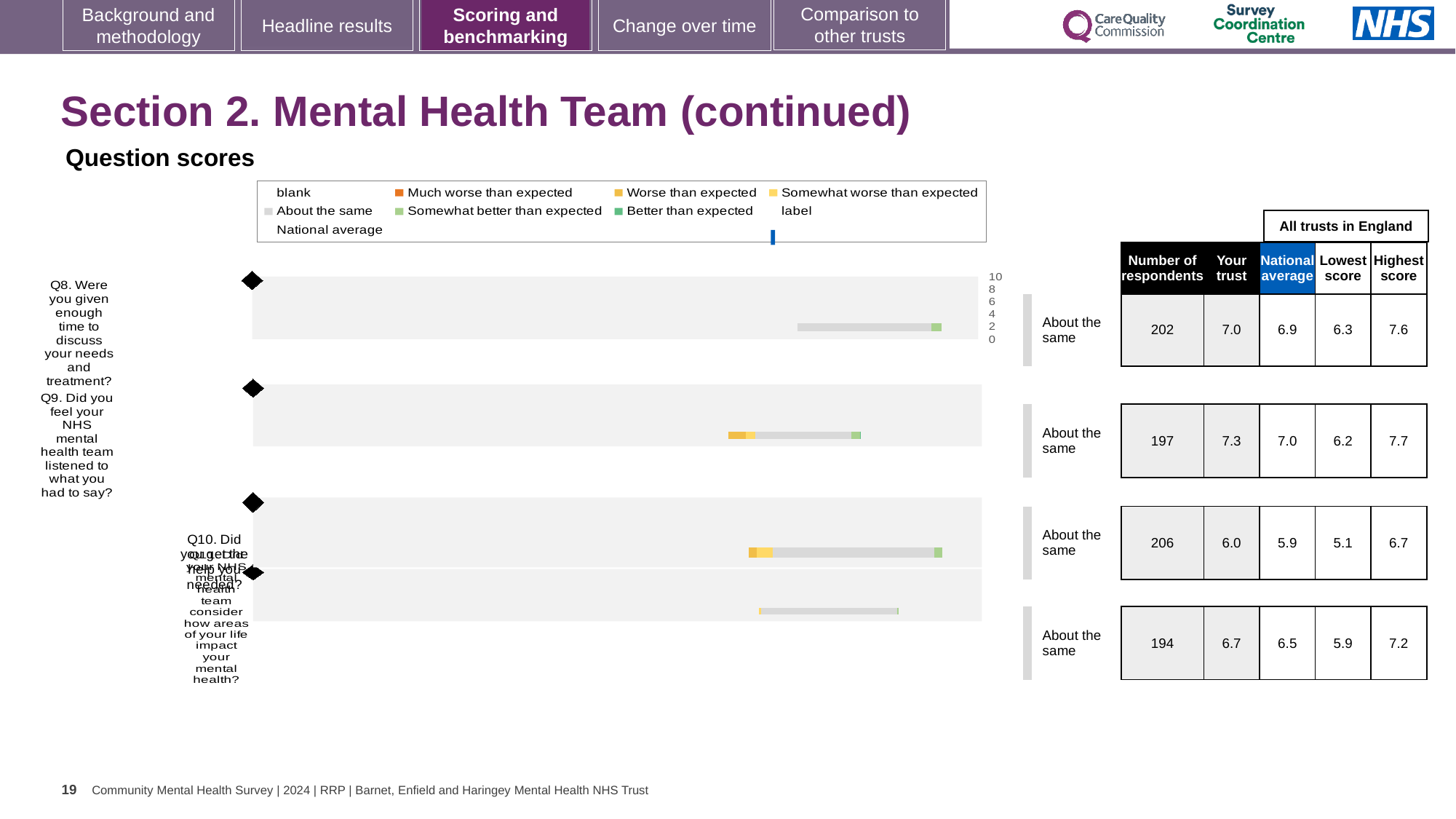
How many question rows (bars) are plotted in the question scores chart? 4 In the legend of the question scores chart, what colour represents 'Better than expected'? green In the table beside the chart, what is the highest score among all trusts in England for Q9? 7.7 In the table beside the chart, which question has the highest 'Your trust' score? Q9 In the table beside the chart, what is the national average for Q9 (Did you feel your NHS mental health team listened to what you had to say?)? 7.0 In the table beside the chart, what is the 'Your trust' score for Q8 (Were you given enough time to discuss your needs and treatment?)? 7.0 In the table beside the chart, how many respondents answered Q10 (Did you get the help you needed?)? 206 In the table beside the chart, which question has the lowest 'Your trust' score? Q10 In the table beside the chart, what is the difference between the 'Your trust' score and the national average for Q10? 0.1 In the legend of the question scores chart, what colour represents 'Much worse than expected'? orange In the table beside the chart, is the 'Your trust' score for Q8 larger or smaller than the 'Your trust' score for Q9? smaller What kind of chart is used to show the question scores on this slide? bar chart